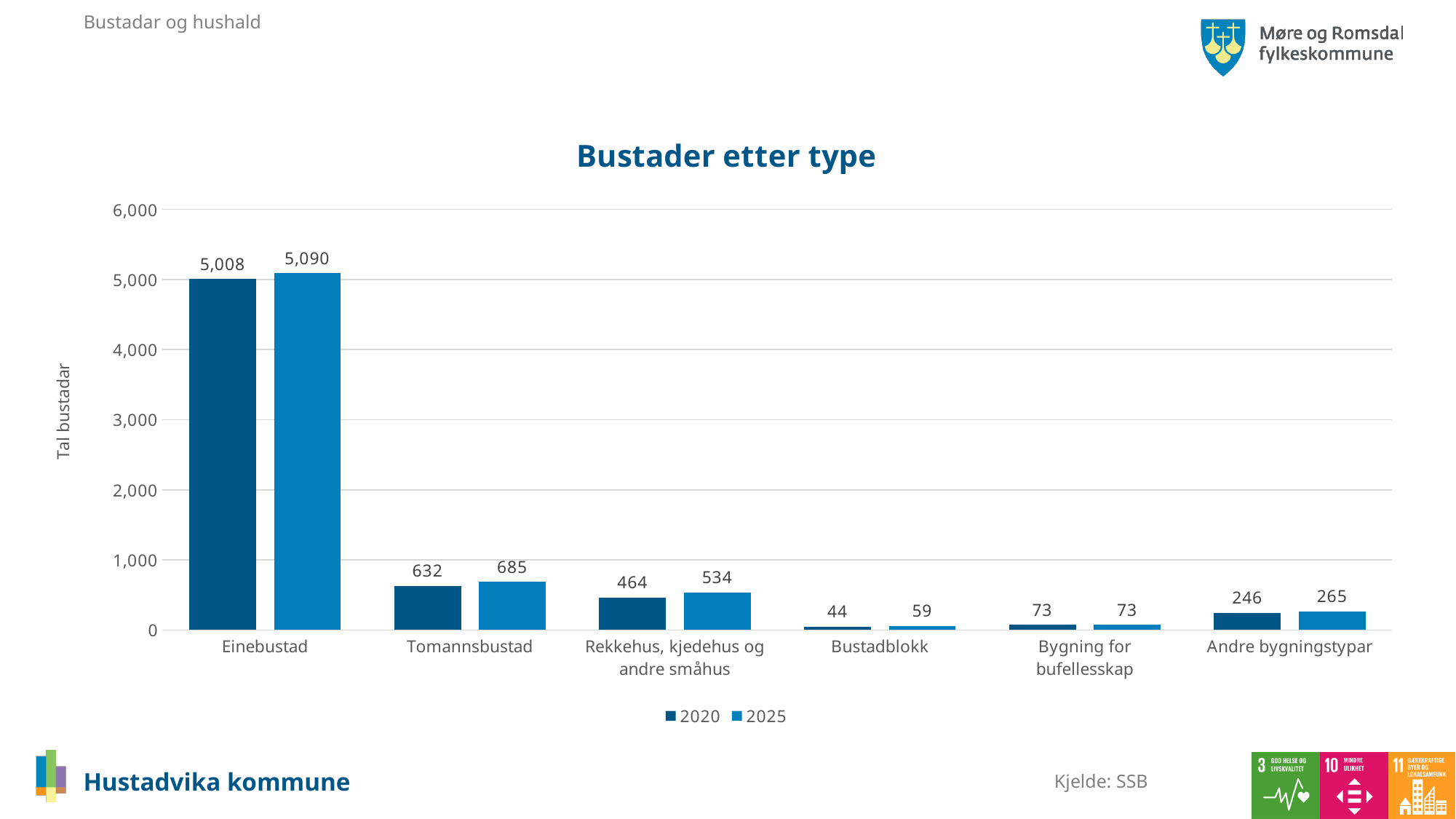
What is the value for Bustadblokk in 2025? 59 What is the title of the chart? Bustader etter type How many series does the legend list? 2 Which category has the highest value in 2020? Einebustad What is the value for Tomannsbustad in 2020? 632 What is the value for Einebustad in 2025? 5,090 What kind of chart is shown? Bar chart Which is larger for Andre bygningstypar: the 2020 value or the 2025 value? 2025 Which category has the lowest value in 2025? Bustadblokk What is the difference between the 2025 and 2020 values for Rekkehus, kjedehus og andre småhus? 70 How many categories are shown on the x axis? 6 What is the difference between the 2025 and 2020 values for Einebustad? 82